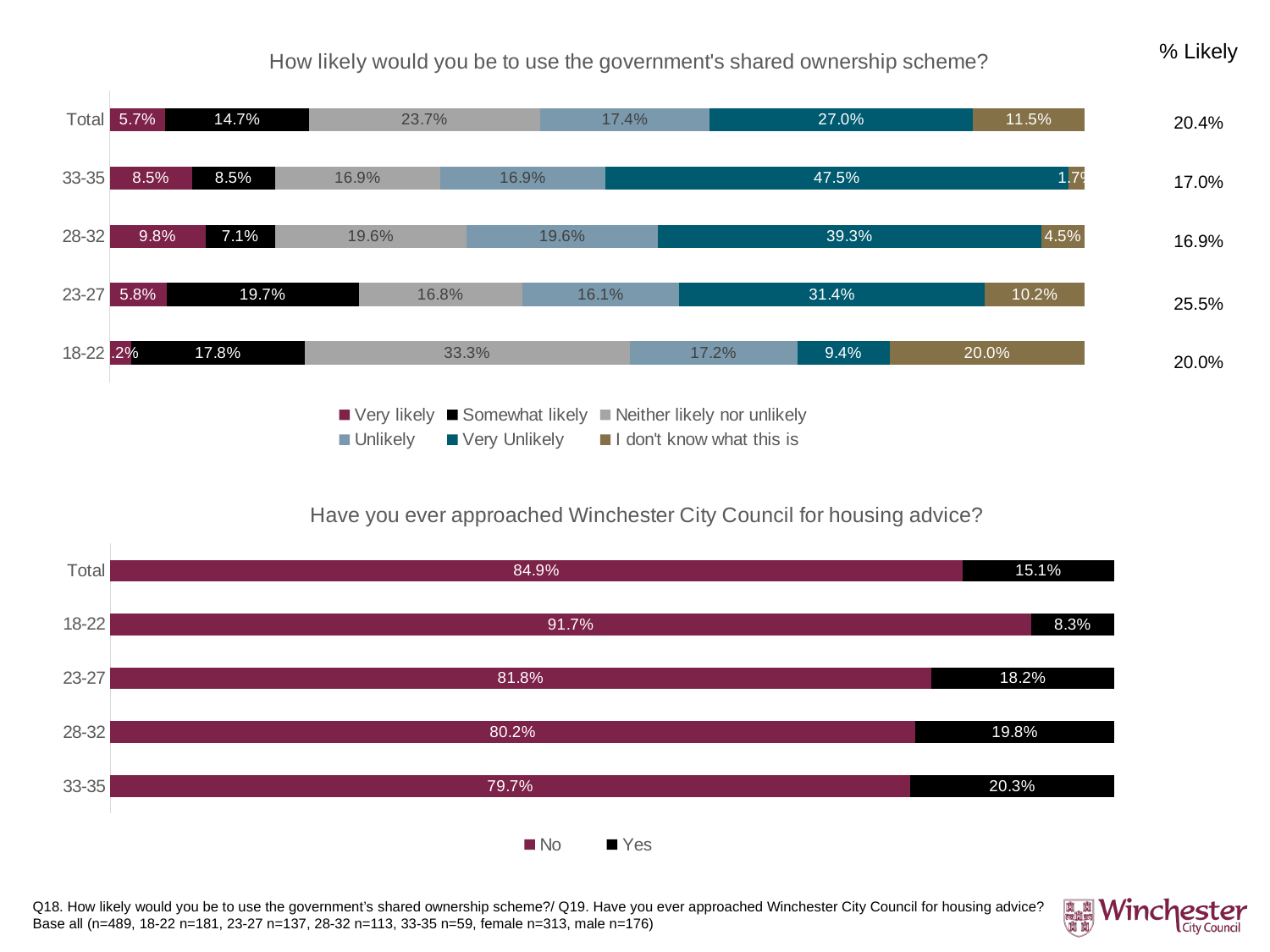
In the chart 'Have you ever approached Winchester City Council for housing advice?', which age group has the highest 'Yes' percentage? 33-35 What type of chart is 'Have you ever approached Winchester City Council for housing advice?' Stacked bar chart In the chart 'How likely would you be to use the government's shared ownership scheme?', what is the '% Likely' figure shown for the 23-27 age group? 25.5% In the chart 'How likely would you be to use the government's shared ownership scheme?', how many series does the legend list? 6 In the chart 'How likely would you be to use the government's shared ownership scheme?', which age group has the highest 'Very Unlikely' percentage? 33-35 In the chart 'Have you ever approached Winchester City Council for housing advice?', how many categories are shown on the vertical axis? 5 In the chart 'How likely would you be to use the government's shared ownership scheme?', which age group has the lowest 'Very Unlikely' percentage? 18-22 In the chart 'How likely would you be to use the government's shared ownership scheme?', what percentage of the Total group said 'Very Unlikely'? 27.0% In the chart 'Have you ever approached Winchester City Council for housing advice?', what percentage of 18-22 year olds answered 'Yes'? 8.3% In the chart 'How likely would you be to use the government's shared ownership scheme?', what percentage of 23-27 year olds said 'Somewhat likely'? 19.7% In the chart 'How likely would you be to use the government's shared ownership scheme?', what is the difference between the 'Neither likely nor unlikely' percentages for 18-22 and 33-35? 16.4% In the chart 'Have you ever approached Winchester City Council for housing advice?', what is the difference between the 'No' percentages for 18-22 and 33-35? 12.0%